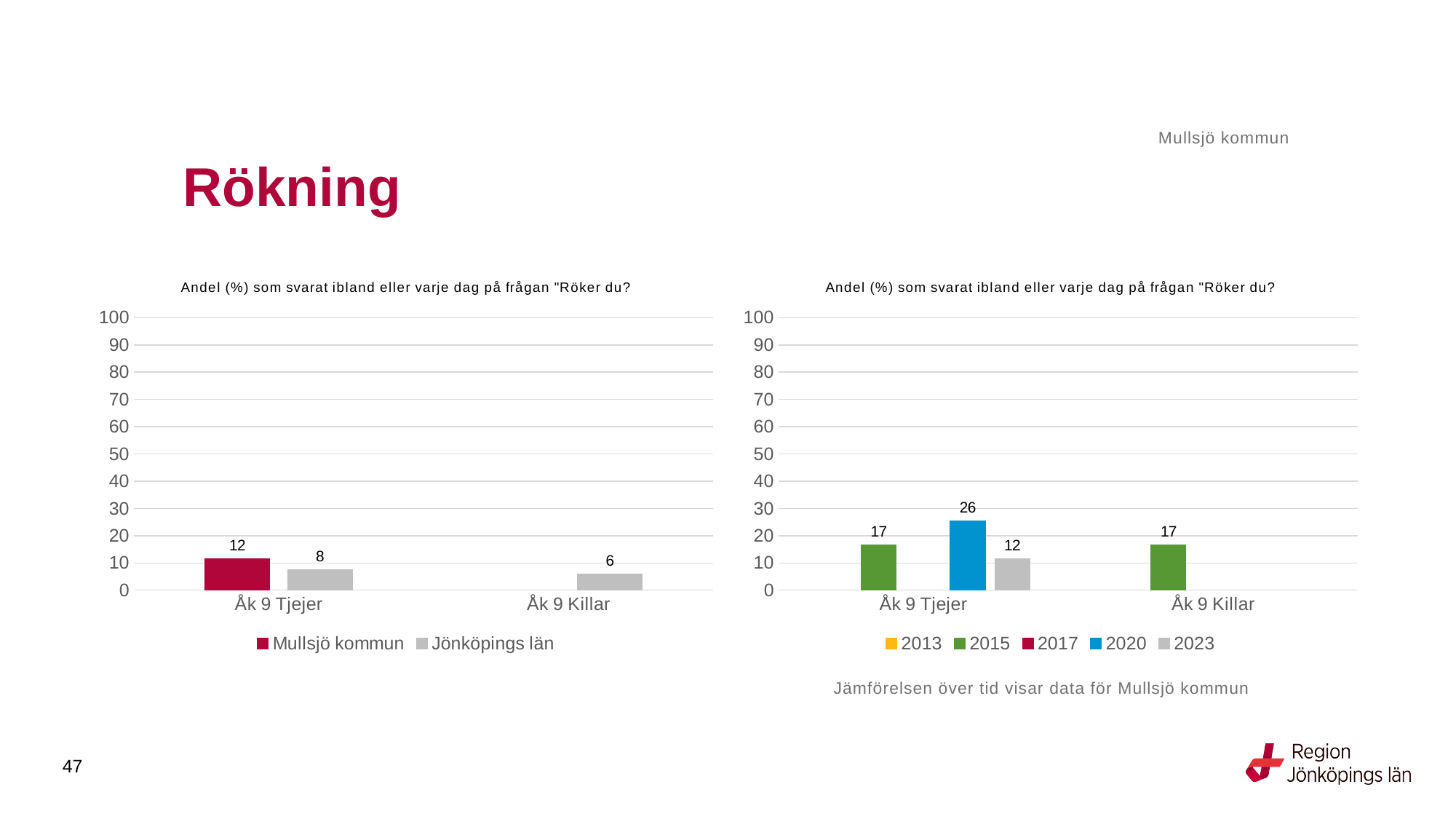
In the right chart, which year has the highest value for Åk 9 Tjejer? 2020 In the right chart, what is the value for 2015 for Åk 9 Killar? 17 How many series does the legend of the left chart list? 2 In the left chart, what is the value for Mullsjö kommun for Åk 9 Tjejer? 12 How many series does the legend of the right chart list? 5 In the left chart, what is the value for Jönköpings län for Åk 9 Killar? 6 In the left chart, which is larger for Åk 9 Tjejer: Mullsjö kommun or Jönköpings län? Mullsjö kommun In the right chart, what is the difference between the 2020 and 2023 values for Åk 9 Tjejer? 14 In the right chart, what is the value for 2020 for Åk 9 Tjejer? 26 What kind of chart is the left chart? Bar chart In the left chart, what is the difference between Mullsjö kommun and Jönköpings län for Åk 9 Tjejer? 4 In the right chart, what is the value for 2023 for Åk 9 Tjejer? 12